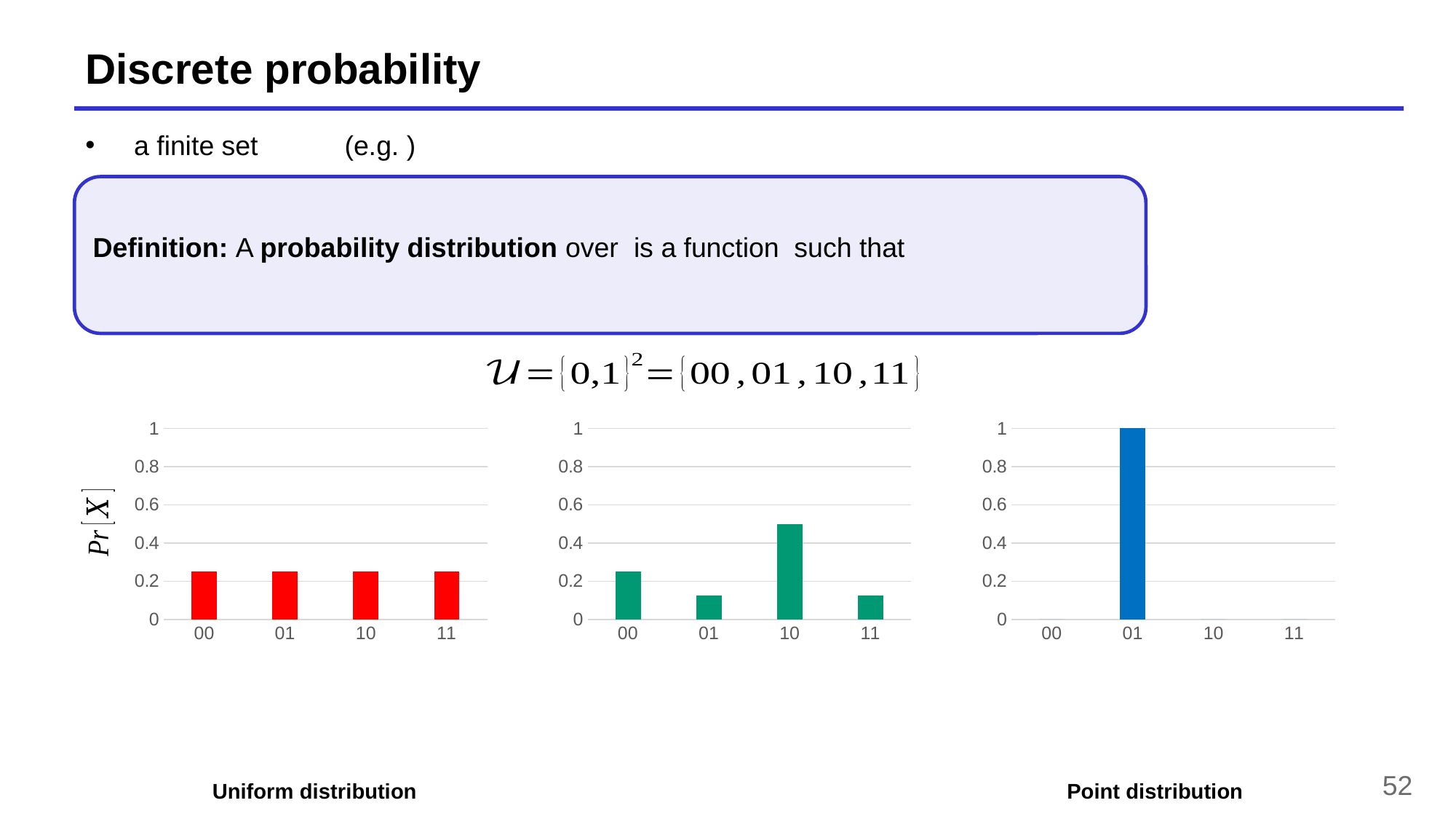
In the middle chart, which is larger, the value for 00 or the value for 10? 10 In the Uniform distribution chart on the left, is the value for 00 greater or less than 0.4? less In the Point distribution chart on the right, what is the value for 01? 1 What is the label written beneath the chart on the right? Point distribution In the Point distribution chart on the right, which category has the highest value? 01 In the middle chart, is the value for 01 greater or less than 0.2? less What kind of chart is the Uniform distribution chart on the left? bar chart In the middle chart, is the value for 10 greater or less than 0.4? greater In the middle chart, which category has the highest value? 10 What colour are the bars in the Uniform distribution chart on the left? red How many categories are shown on the x axis of the middle chart? 4 In the Uniform distribution chart on the left, do the values rise, fall, or stay the same across the x axis? stay the same